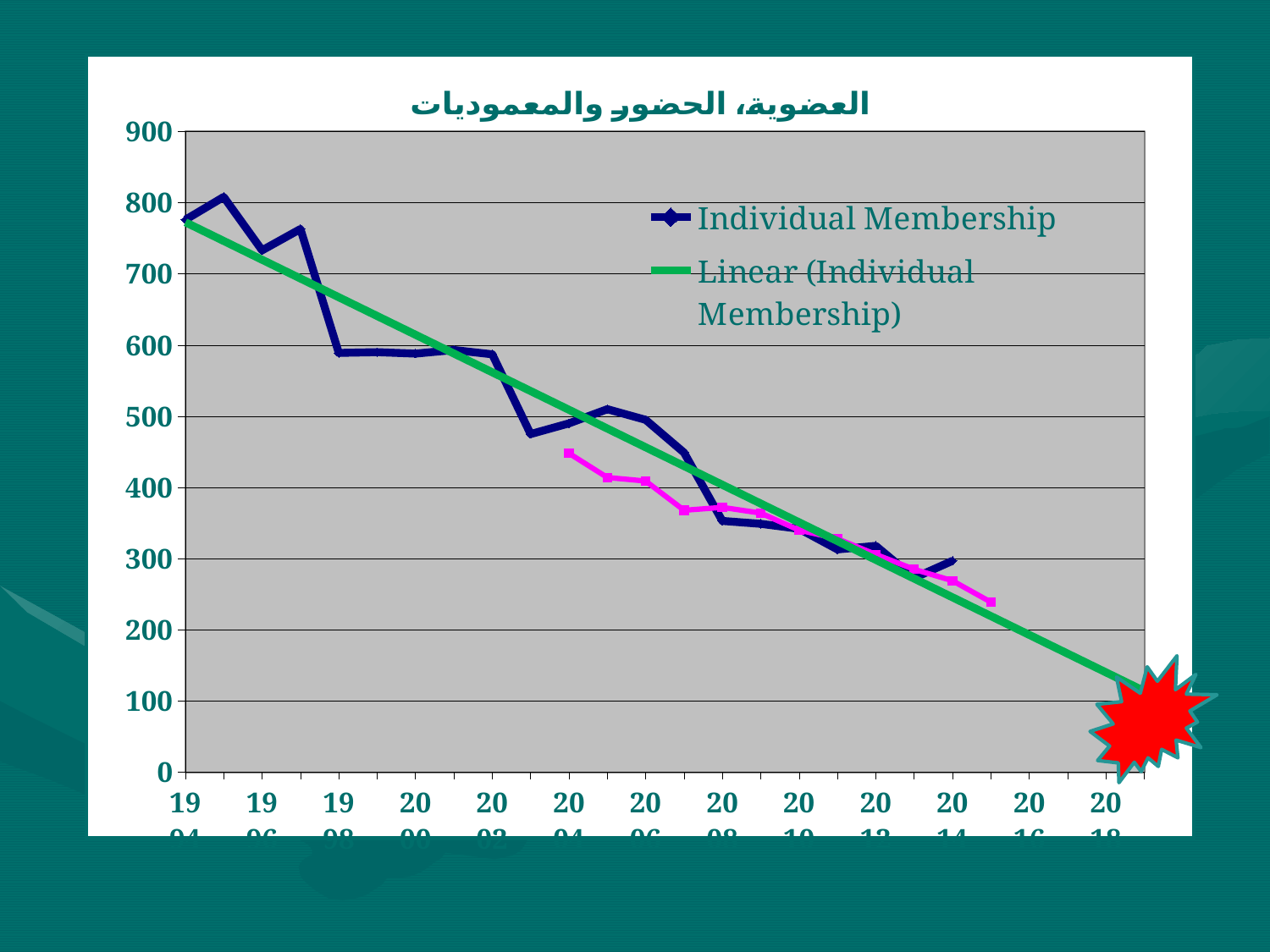
Is the Linear (Individual Membership) trend line value at 2018 greater or less than 200? less What colour is the Linear (Individual Membership) trend line? Green Is the Individual Membership value for 2008 greater or less than 400? less Is the Individual Membership value for 2014 greater or less than 400? less Does the Individual Membership line generally rise or fall from 1994 to 2014? Fall What are the two entries listed in the legend? Individual Membership; Linear (Individual Membership) How many series does the legend list? 2 What kind of chart is shown on the slide? Line chart Does the Linear (Individual Membership) trend line rise or fall along the x axis? Fall